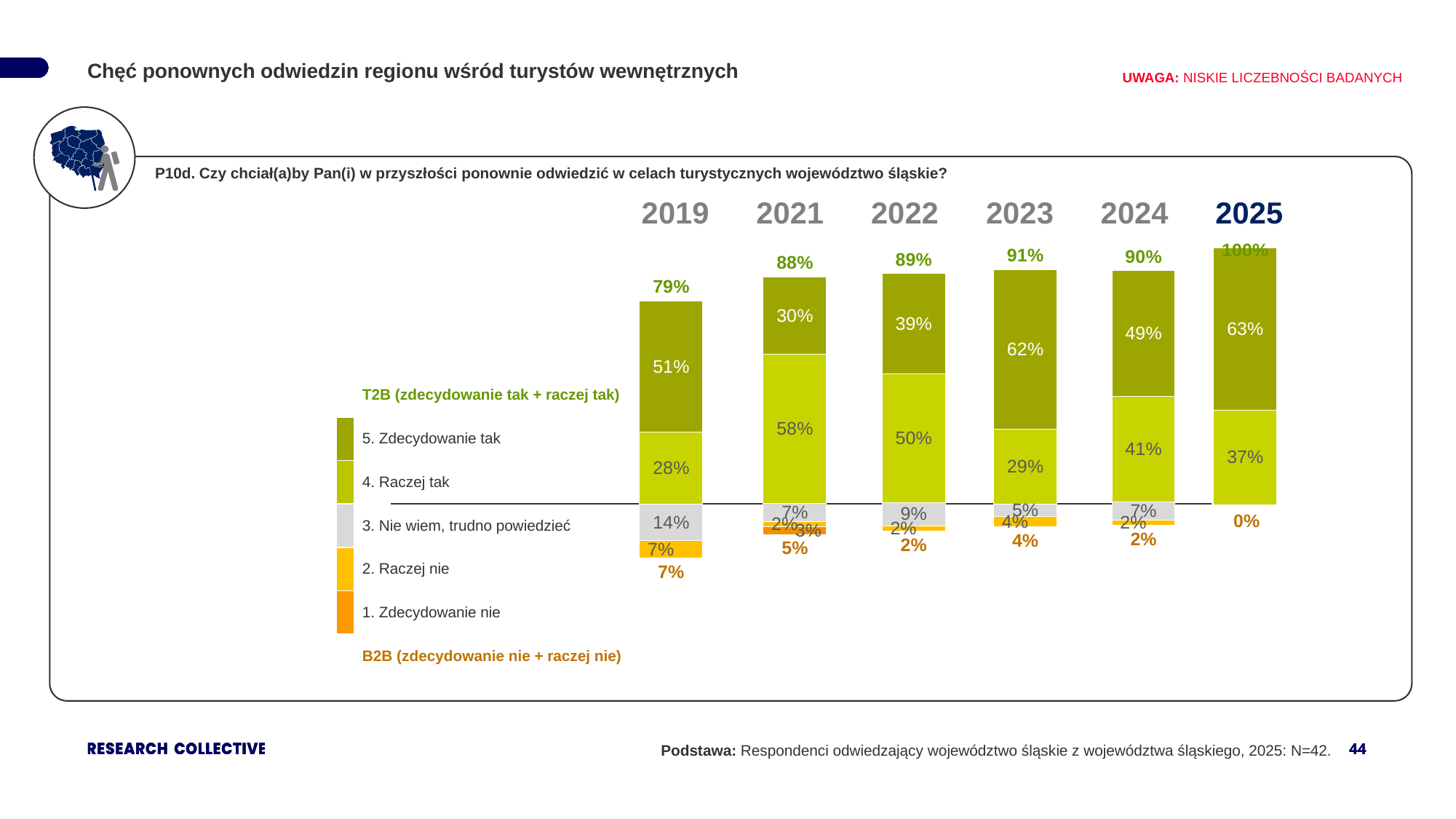
What is the T2B (zdecydowanie tak + raczej tak) value for 2019? 79% What is the share of '3. Nie wiem, trudno powiedzieć' in 2019? 14% Which year has the highest T2B value? 2025 What is the B2B (zdecydowanie nie + raczej nie) value for 2025? 0% Which year has the lowest T2B value? 2019 Which is larger: the share of '5. Zdecydowanie tak' in 2024 or in 2022? 2024 How many response categories does the legend list? 5 What is the difference between the T2B values for 2025 and 2019? 21 percentage points What is the share of '4. Raczej tak' in 2021? 58% How many years (categories) are shown on the chart? 6 What is the share of '5. Zdecydowanie tak' in 2023? 62% What kind of chart is shown on the slide? stacked bar chart